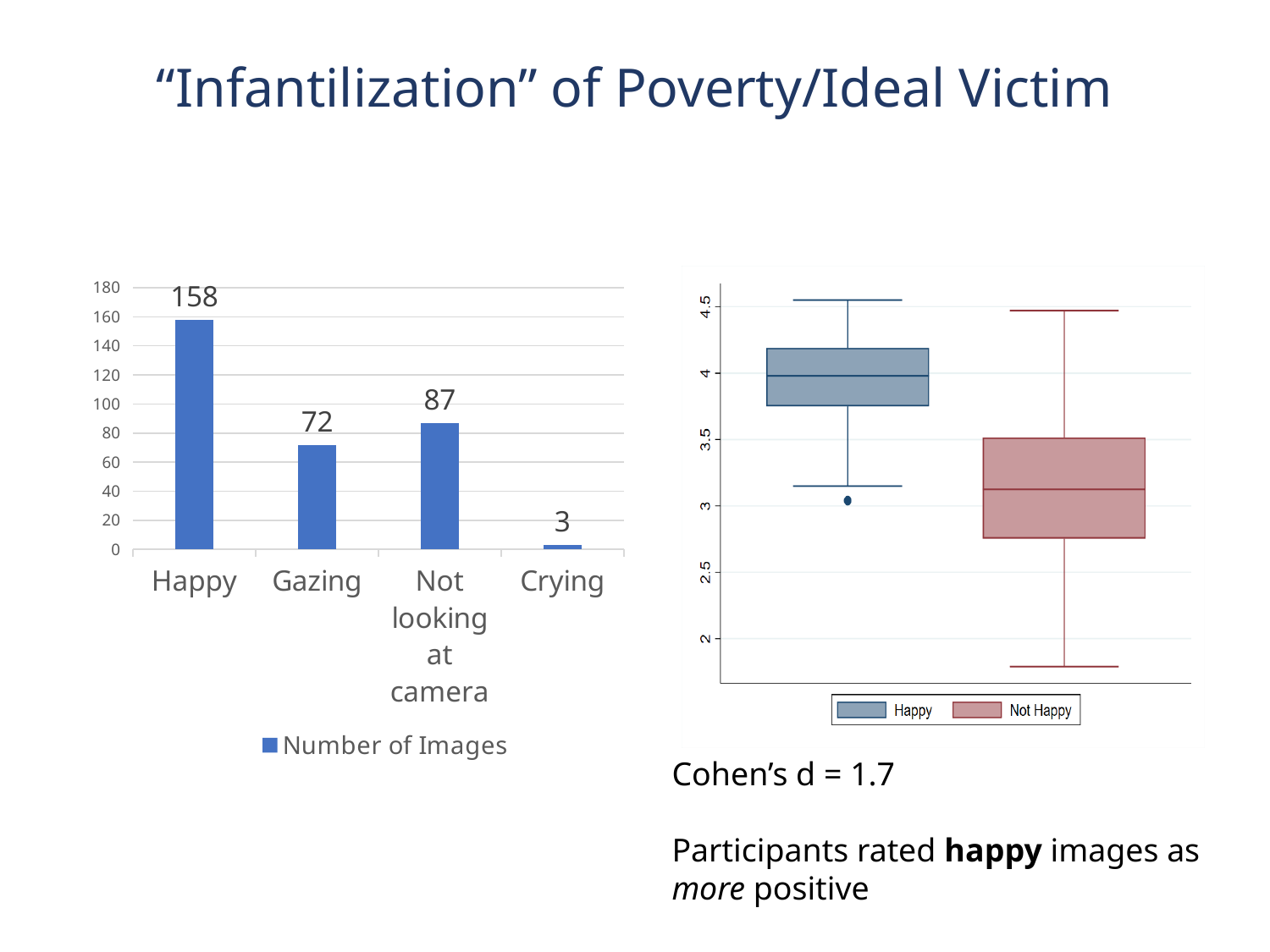
How many series does the legend of the box plot on the right list? 2 In the bar chart on the left, what is the value for Crying? 3 In the box plot on the right, is the median for Happy greater or less than 3.5? greater In the bar chart on the left, which is larger: Gazing or Not looking at camera? Not looking at camera In the bar chart on the left, which category has the lowest number of images? Crying In the bar chart on the left, what is the difference between the Happy and Gazing values? 86 How many categories are shown in the bar chart on the left? 4 In the bar chart on the left, what is the value for Gazing? 72 In the bar chart on the left, how many images are in the Happy category? 158 In the bar chart on the left, what is the value for Not looking at camera? 87 What kind of chart is the chart on the right of the slide? Box plot In the bar chart on the left, which category has the highest number of images? Happy